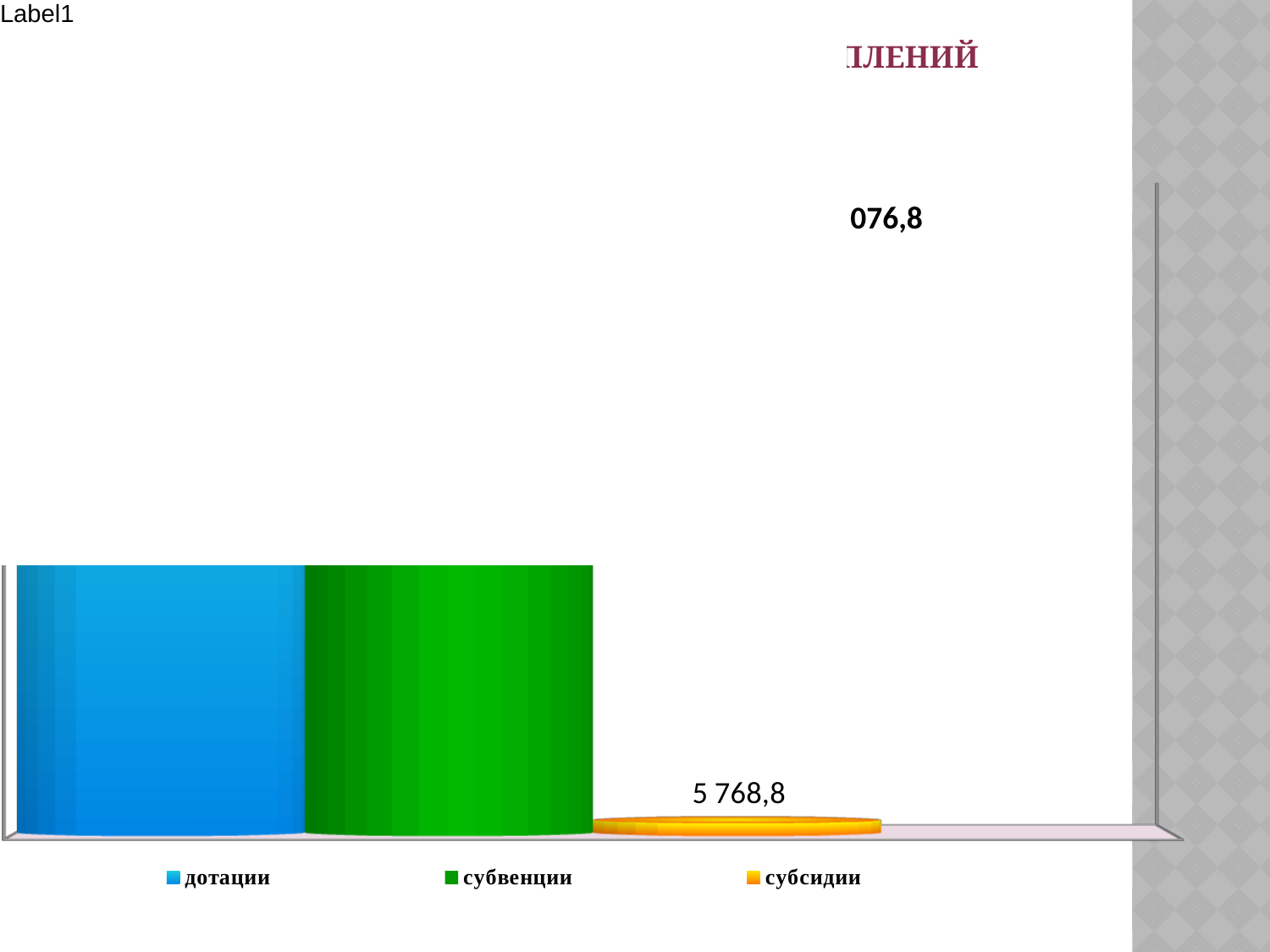
What colour is the дотации bar? blue How many bars are plotted on the chart? 3 Which is larger, the value for субвенции or the value for субсидии? субвенции Which is larger, the value for дотации or the value for субсидии? дотации Which series has the lowest value? субсидии What value is labelled on the субсидии bar? 5 768,8 What kind of chart is shown on the slide? bar chart How many series does the legend list? 3 Which series is shown in green in the legend? субвенции